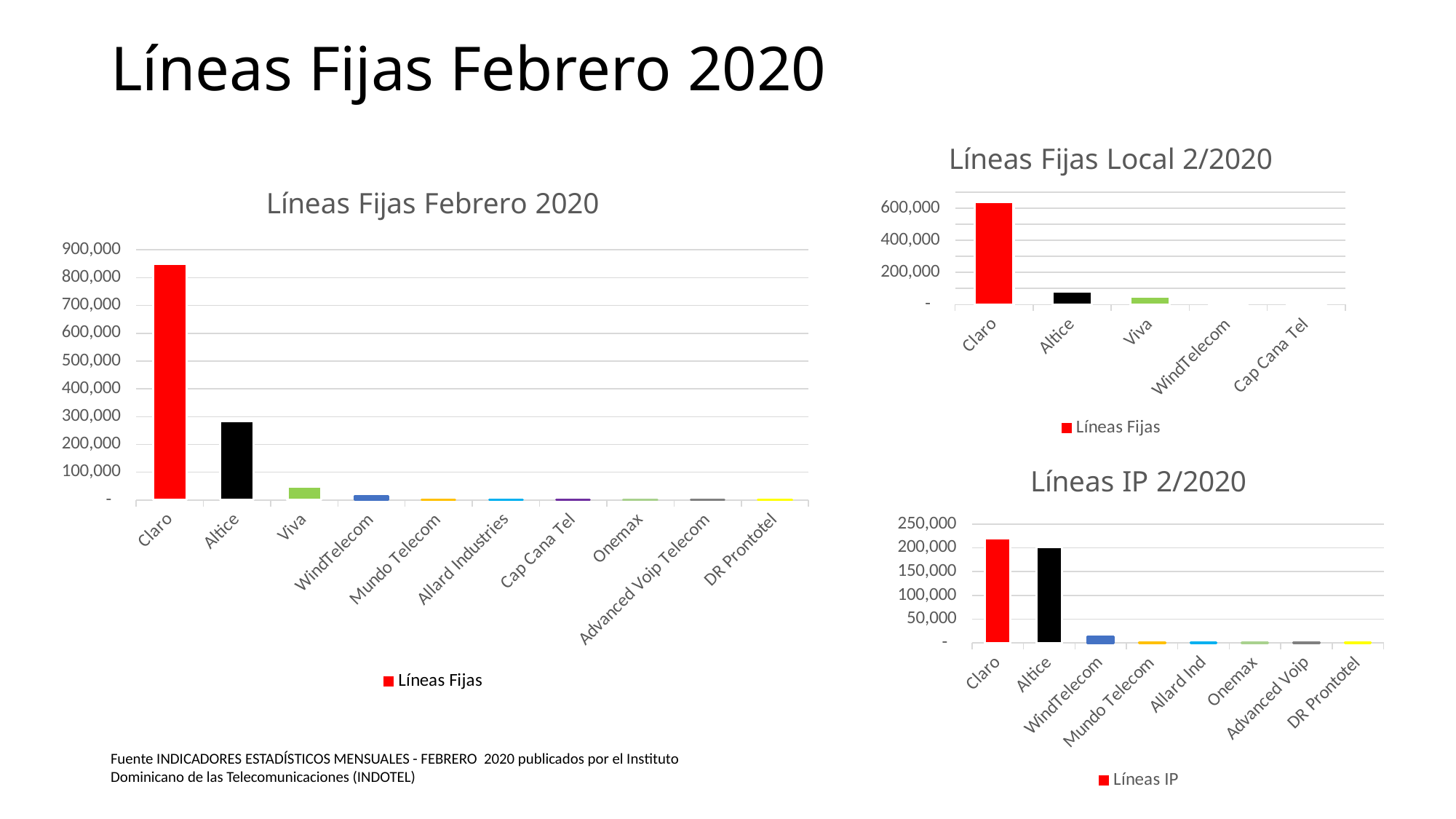
In the 'Líneas Fijas Local 2/2020' chart, how many categories are shown on the x axis? 5 What is the legend entry shown below the 'Líneas IP 2/2020' chart? Líneas IP In the 'Líneas Fijas Febrero 2020' chart, is the value for Claro greater or less than 800,000? greater In the 'Líneas Fijas Febrero 2020' chart, which is larger, the value for Viva or the value for WindTelecom? Viva In the 'Líneas IP 2/2020' chart, is the value for Altice greater or less than 150,000? greater In the 'Líneas IP 2/2020' chart, how many categories are shown on the x axis? 8 In the 'Líneas Fijas Local 2/2020' chart, is the value for Claro greater or less than 600,000? greater In the 'Líneas Fijas Febrero 2020' chart, which category has the highest value? Claro In the 'Líneas Fijas Febrero 2020' chart, how many categories are shown on the x axis? 10 What kind of chart is 'Líneas Fijas Local 2/2020'? bar chart In the 'Líneas IP 2/2020' chart, which category has the highest value? Claro